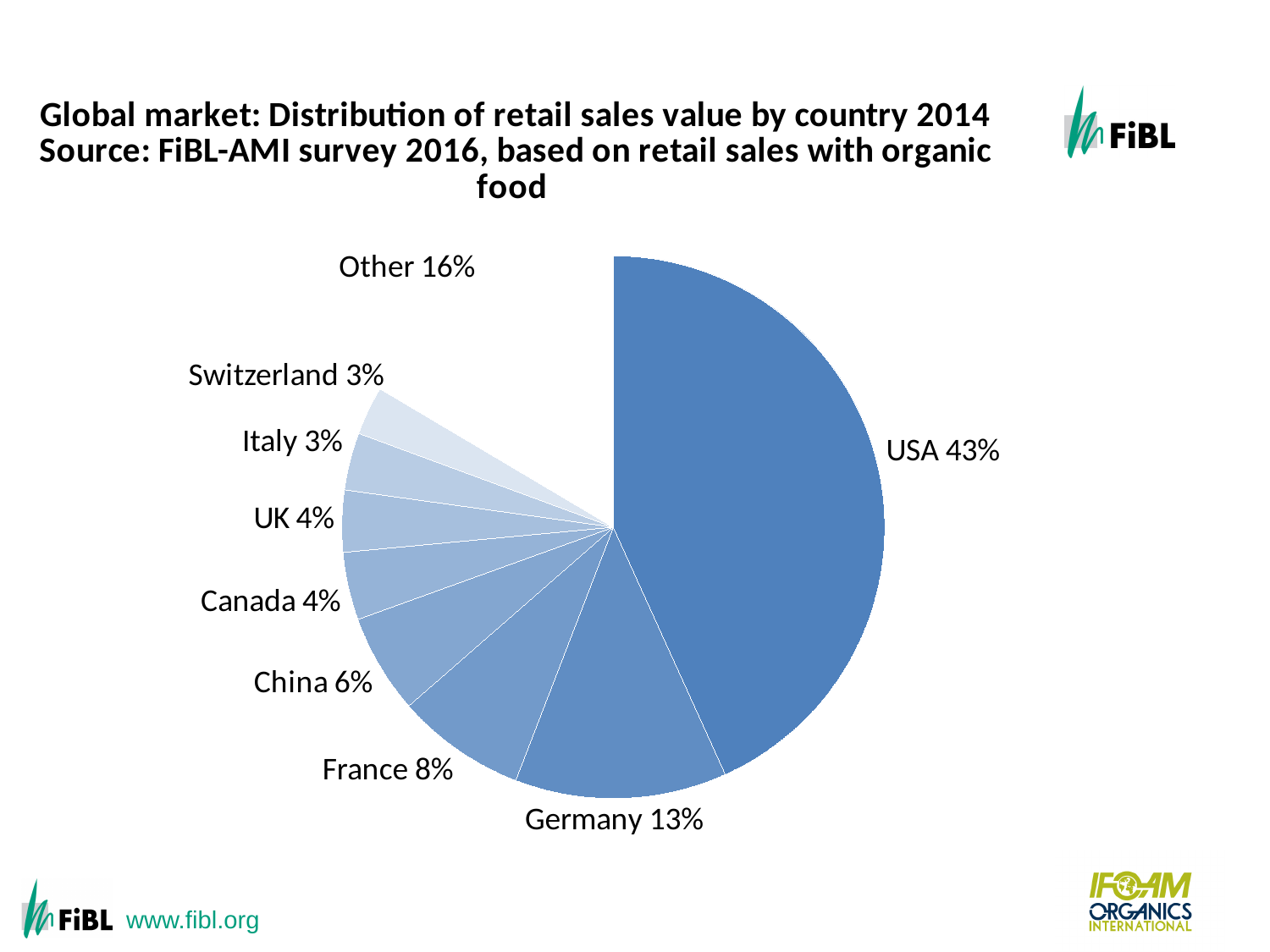
What is the combined share of the UK and Canada? 8% Which has a larger share, France or China? France What share is labelled for Switzerland? 3% What share of retail sales value does France hold? 8% What kind of chart is shown on the slide? pie chart What share of retail sales value does the USA hold? 43% What is the difference between the USA's share and Germany's share? 30% How many slices does the pie chart have? 9 What is the title of the chart? Global market: Distribution of retail sales value by country 2014 Which country has the largest share of retail sales value? USA What share of retail sales value does China hold? 6% What share of retail sales value does Germany hold? 13%